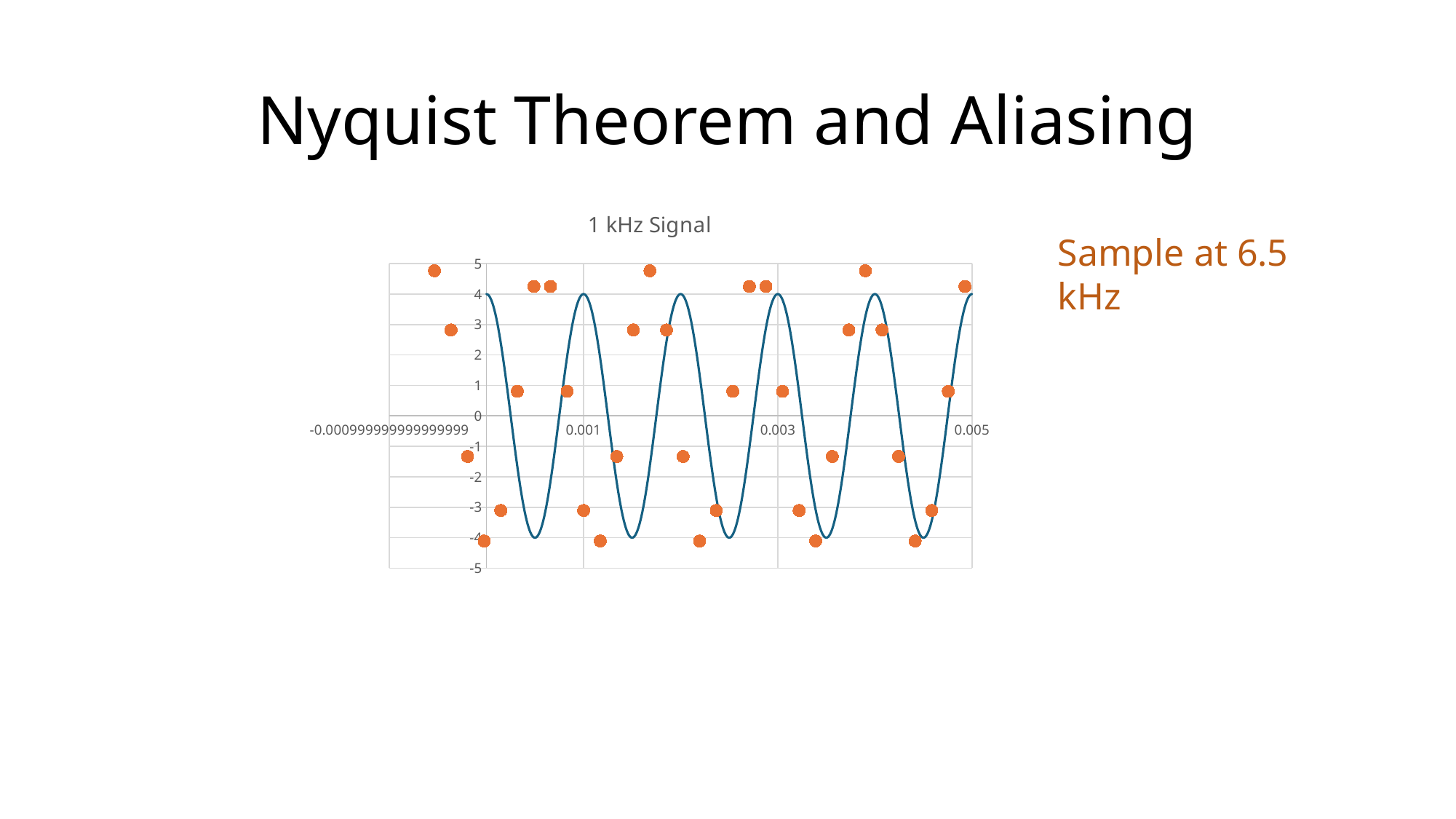
What is the lowest tick value shown on the y axis? -5 What is the rightmost tick label on the x axis? 0.005 What colour are the sample points plotted on the chart? orange What is the highest tick value shown on the y axis? 5 What is the maximum value the blue curve reaches on the y axis? 4 What is the title of the chart? 1 kHz Signal What is the minimum value the blue curve reaches on the y axis? -4 What kind of chart is shown on the slide? line chart with scatter points